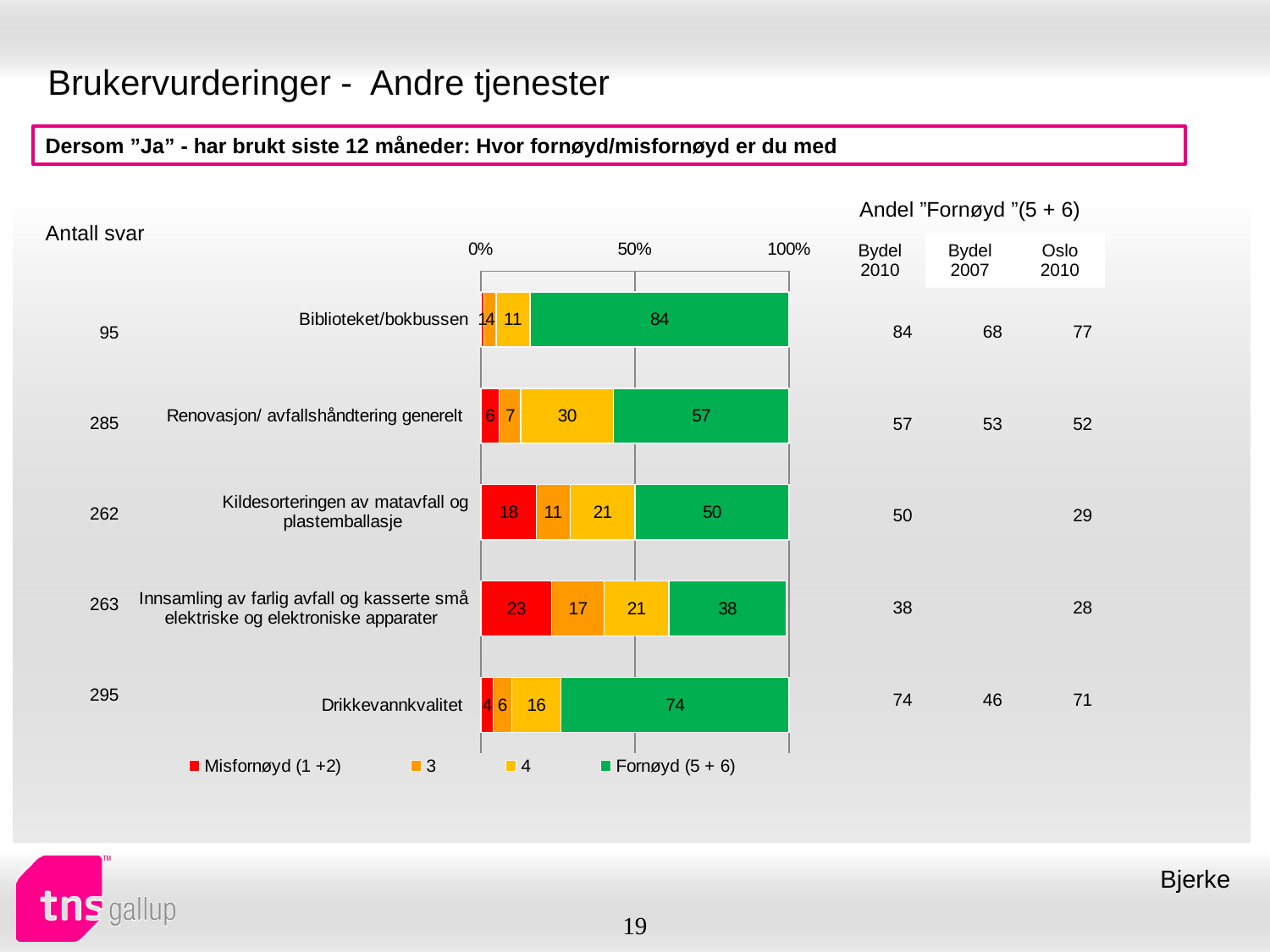
How many series does the legend list? 4 Which category has the highest Fornøyd (5 + 6) value? Biblioteket/bokbussen What is the Misfornøyd (1 +2) value for Innsamling av farlig avfall og kasserte små elektriske og elektroniske apparater? 23 What is the value of series 4 for Renovasjon/ avfallshåndtering generelt? 30 What is the difference between the Fornøyd (5 + 6) values for Drikkevannkvalitet and Kildesorteringen av matavfall og plastemballasje? 24 What kind of chart is shown on the slide? Stacked bar chart What is the Fornøyd (5 + 6) value for Biblioteket/bokbussen? 84 Which has a larger Misfornøyd (1 +2) value: Kildesorteringen av matavfall og plastemballasje or Renovasjon/ avfallshåndtering generelt? Kildesorteringen av matavfall og plastemballasje How many categories are shown in the chart? 5 Which colour represents Fornøyd (5 + 6) in the chart? Green Which category has the lowest Fornøyd (5 + 6) value? Innsamling av farlig avfall og kasserte små elektriske og elektroniske apparater What is the value of series 3 for Kildesorteringen av matavfall og plastemballasje? 11